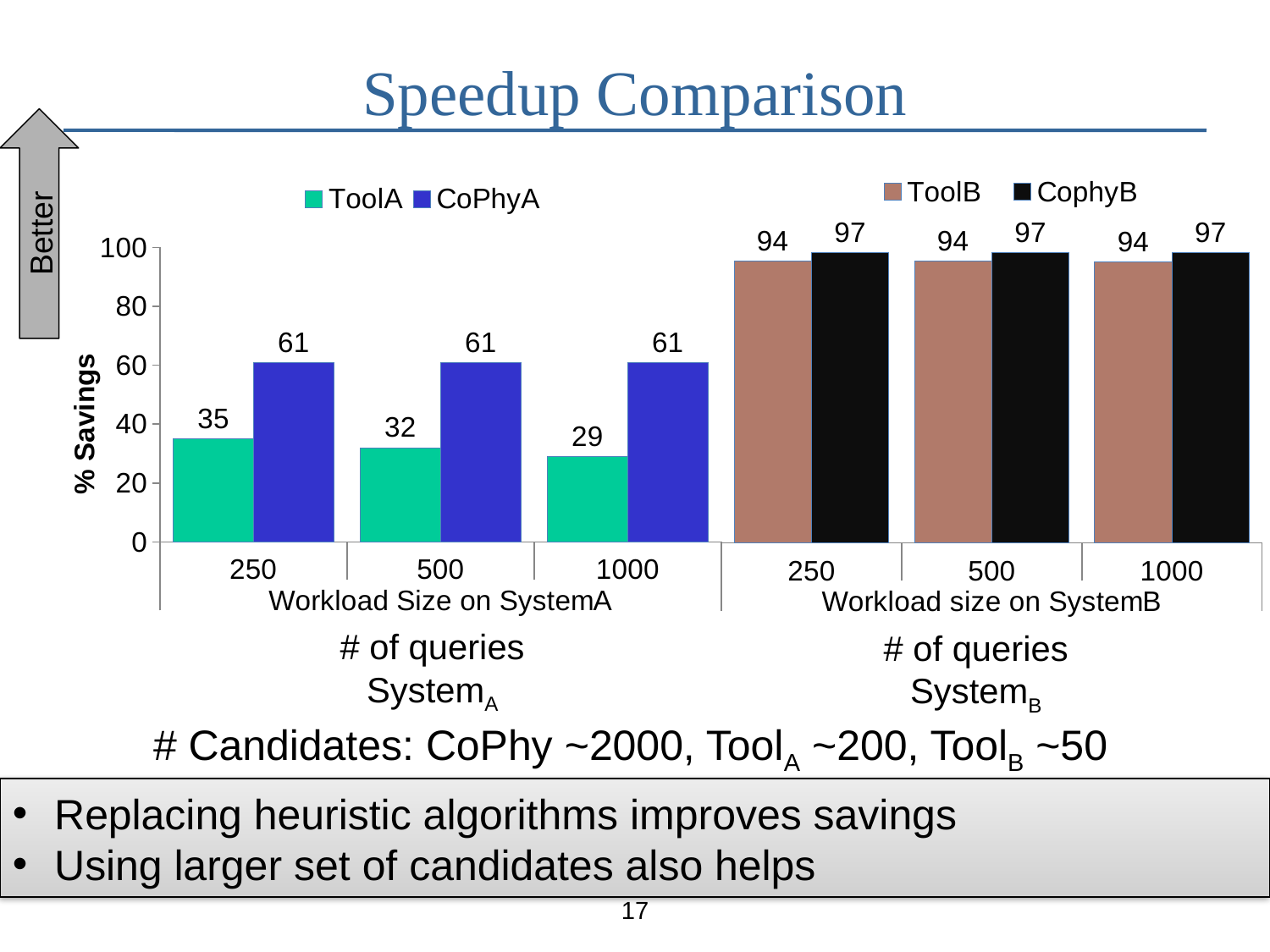
What is the % Savings value for ToolA at workload size 250 on SystemA? 35 What is the difference in % Savings between CoPhyA and ToolA at workload size 1000 on SystemA? 32 Which is larger: the ToolA value at workload size 250 or the ToolA value at workload size 500? ToolA at 250 What is the difference in % Savings between CophyB and ToolB at workload size 500 on SystemB? 3 At which workload size on SystemA does ToolA have its lowest % Savings? 1000 What is the % Savings value for CoPhyA at workload size 500 on SystemA? 61 What is the % Savings value for CophyB at workload size 250 on SystemB? 97 What is the % Savings value for ToolB at workload size 1000 on SystemB? 94 Do the ToolA % Savings values rise or fall as the workload size on SystemA increases from 250 to 1000? fall What is the label on the vertical axis of the chart? % Savings What kind of chart is shown on the slide? bar chart How many series does the legend above the SystemA bars list? 2